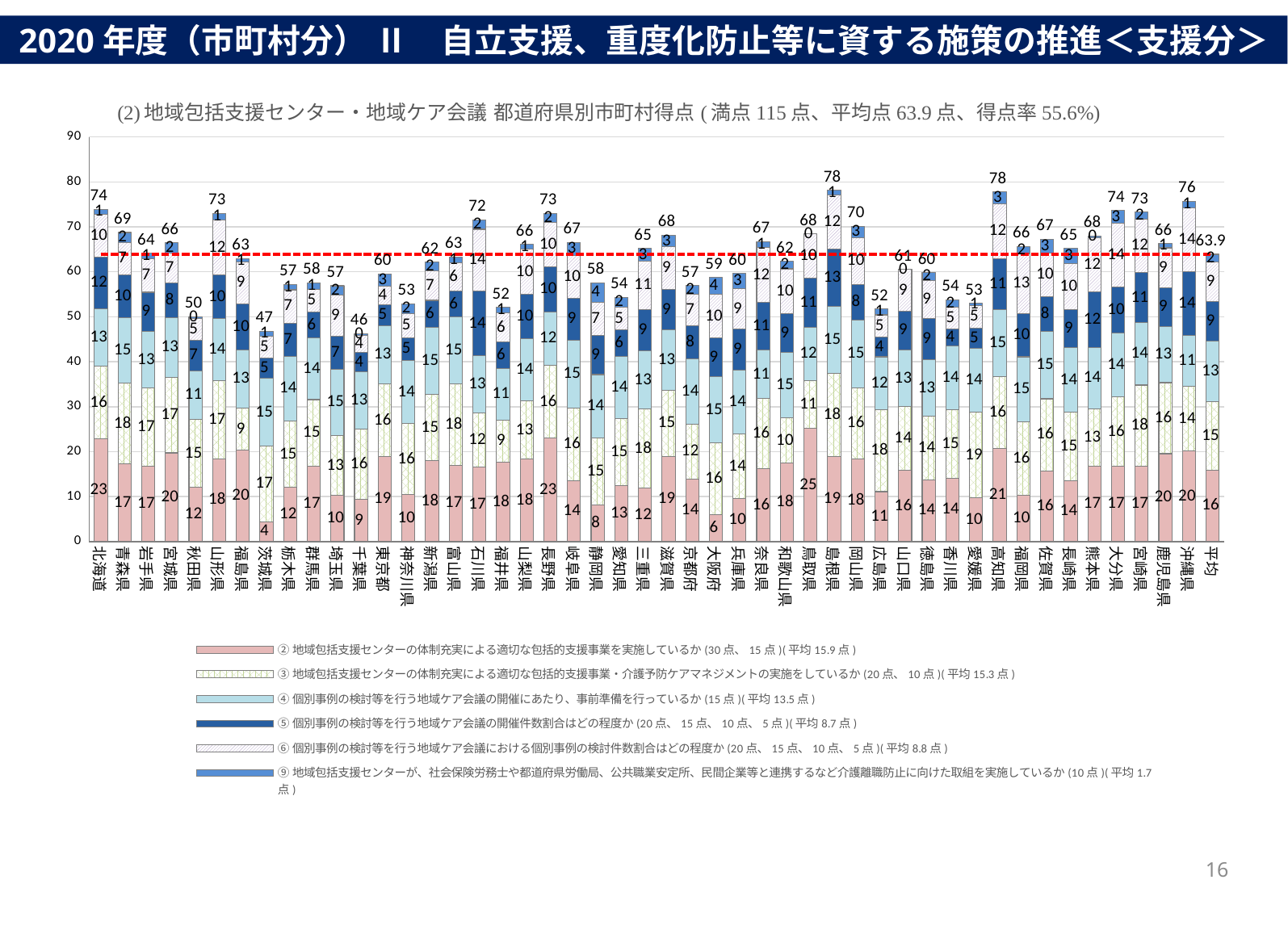
What is the total score shown above the bar for 千葉県? 46 Which prefecture has the lowest total score in the chart? 千葉県 What kind of chart is shown on the slide? stacked bar chart What is the difference between the total scores of 北海道 and 秋田県? 24 What is the total score shown for 平均 (the average bar at the far right)? 63.9 Which has a higher total score, 山形県 or 福島県? 山形県 What is the value of the bottom (pink) segment for 鳥取県? 25 What is the total score shown above the bar for 島根県? 78 What value does the red dashed horizontal line represent? 63.9 (平均点) Is the total score for 茨城県 greater or less than 50? less How many series does the legend list? 6 What is the total score shown above the bar for 沖縄県? 76